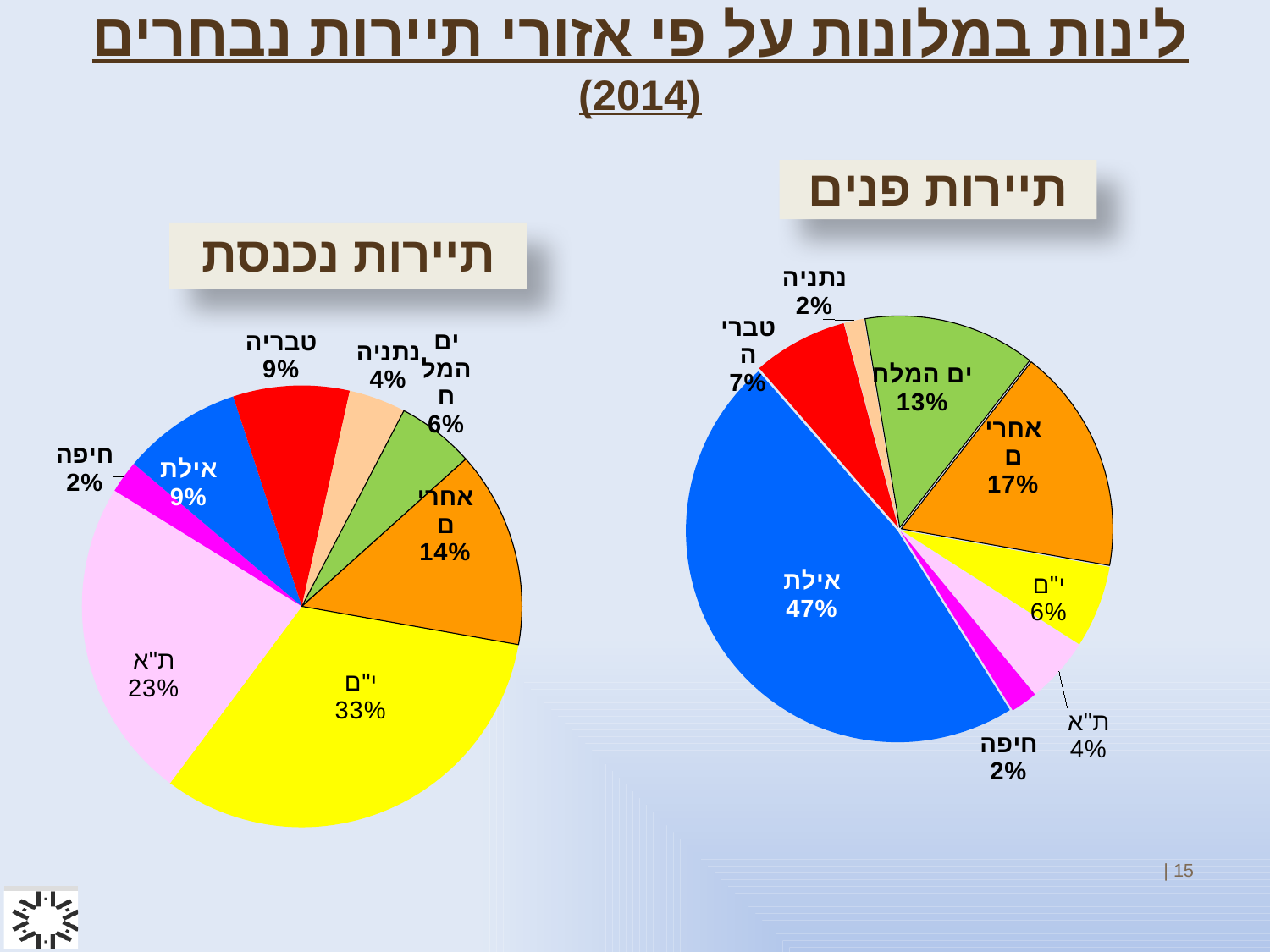
In the תיירות נכנסת pie chart, which region has the smallest share? חיפה In the תיירות פנים pie chart, what share does ים המלח have? 13% What type of chart is used for תיירות נכנסת? Pie chart In the תיירות נכנסת pie chart, what share does ת"א have? 23% In the תיירות פנים pie chart, what is the difference between the shares of אילת and אחרים? 30% In the תיירות נכנסת pie chart, which region has the largest share? י"ם What year is shown in the slide title? 2014 How many slices does the תיירות פנים pie chart have? 8 In the תיירות נכנסת pie chart, what share does י"ם have? 33% In the תיירות פנים pie chart, which region has the largest share? אילת In the תיירות נכנסת pie chart, which is larger: the share of ת"א or the share of אחרים? ת"א In the תיירות פנים pie chart, what share does אילת have? 47%